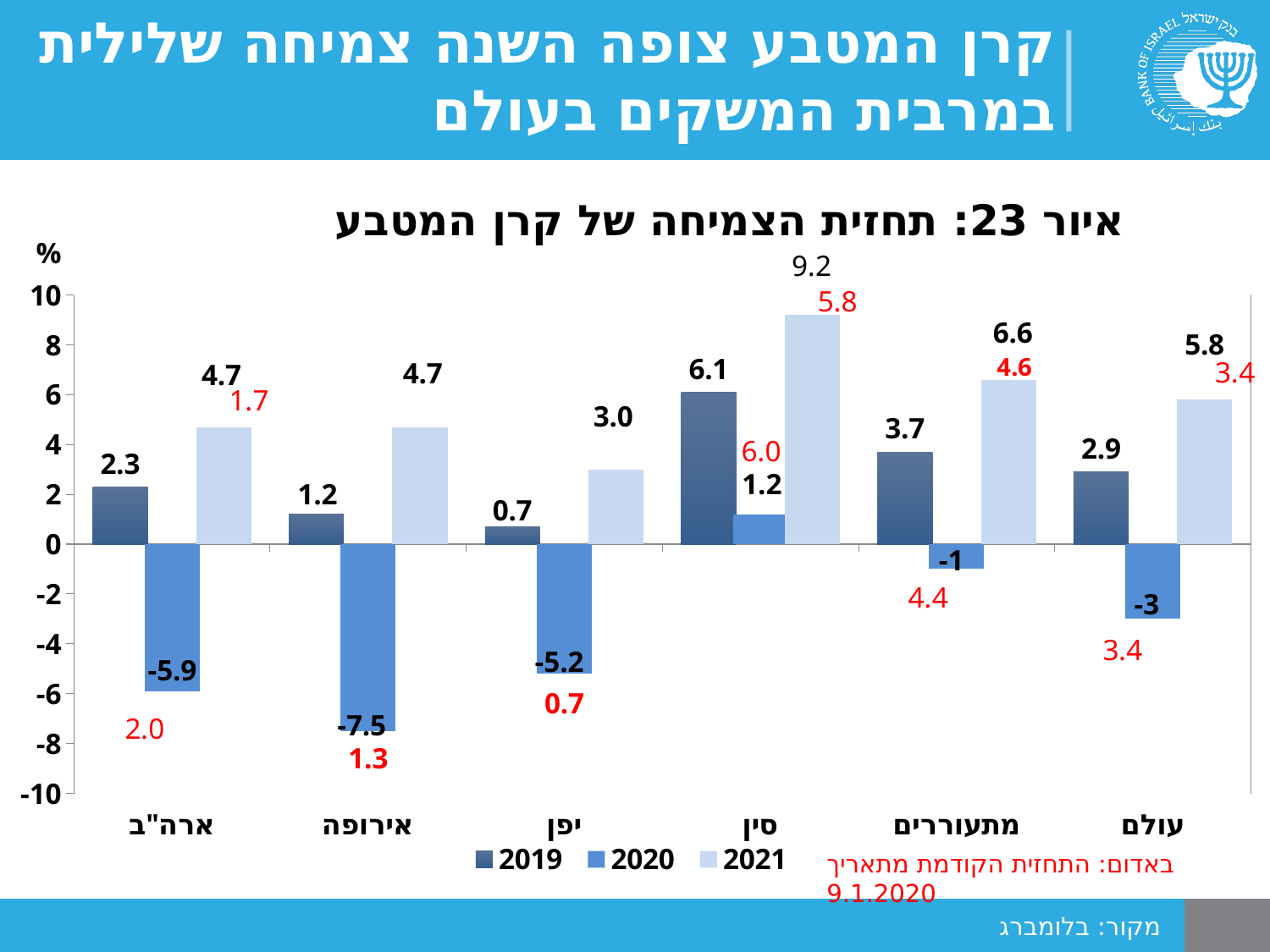
What kind of chart is shown? bar chart What is the 2019 value for עולם? 2.9 Which is larger, the 2019 value for סין or the 2019 value for מתעוררים? סין Which category has the lowest 2020 value? אירופה How many series does the legend list? 3 What is the difference between the 2021 and 2019 values for מתעוררים? 2.9 What is the 2021 value for סין? 9.2 How many categories are shown on the x axis? 6 Which category has the highest 2021 value? סין What unit is shown at the top of the y axis? % What is the 2020 value for אירופה? -7.5 Is the 2020 value for ארה"ב greater or less than -4? less